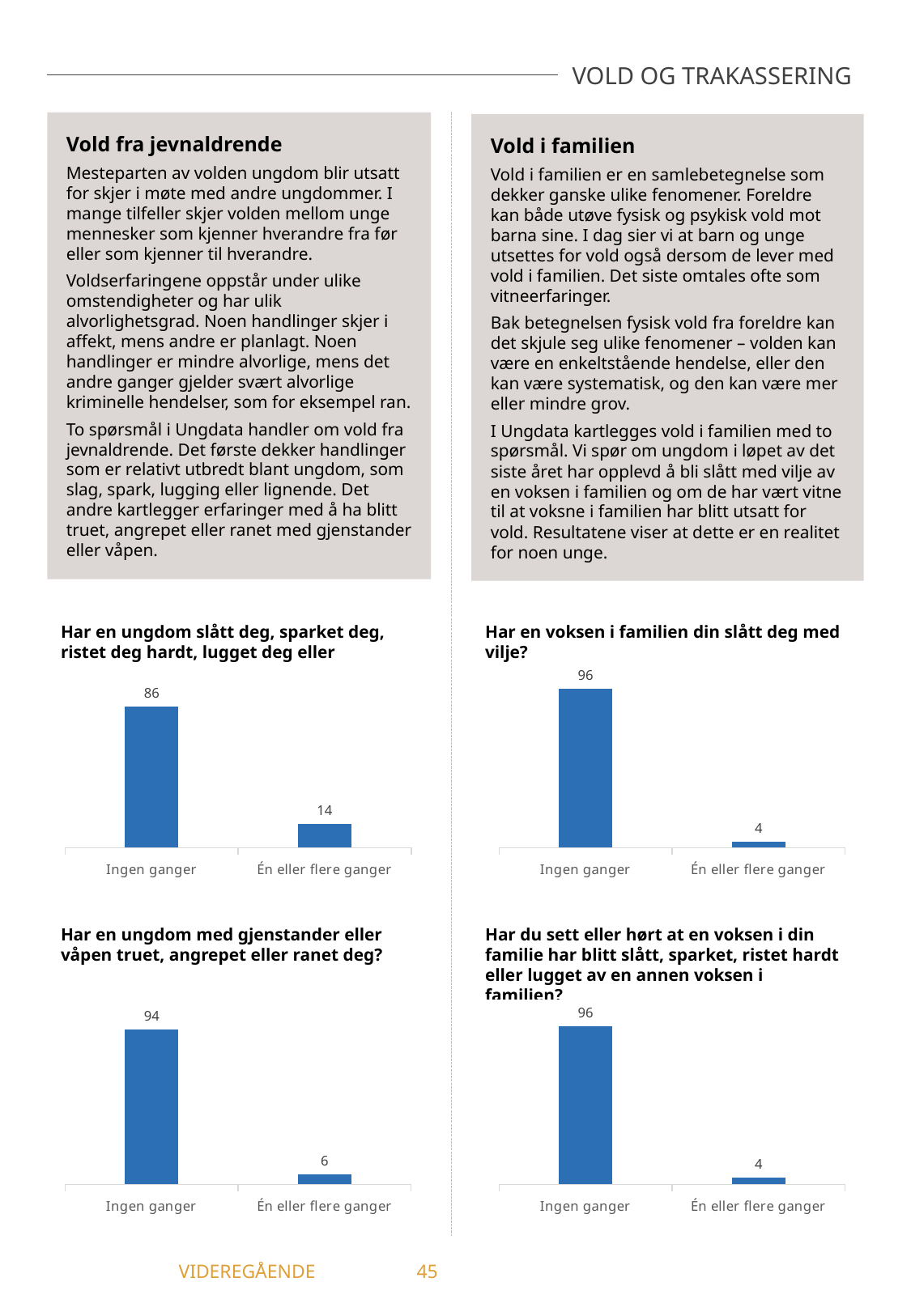
How many categories are shown in the bottom-right chart ("Har du sett eller hørt at en voksen i din familie har blitt slått...")? 2 In the bottom-right chart ("Har du sett eller hørt at en voksen i din familie har blitt slått..."), what is the value for "Én eller flere ganger"? 4 What type of chart is the top-left chart ("Har en ungdom slått deg, sparket deg...")? Bar chart In the bottom-left chart ("Har en ungdom med gjenstander eller våpen truet, angrepet eller ranet deg?"), what is the value for "Én eller flere ganger"? 6 In the bottom-left chart ("Har en ungdom med gjenstander eller våpen truet..."), what is the difference between "Ingen ganger" and "Én eller flere ganger"? 88 In the top-left chart ("Har en ungdom slått deg, sparket deg..."), what is the difference between "Ingen ganger" and "Én eller flere ganger"? 72 In the bottom-left chart ("Har en ungdom med gjenstander eller våpen truet, angrepet eller ranet deg?"), what is the value for "Ingen ganger"? 94 In the top-left chart ("Har en ungdom slått deg, sparket deg..."), what is the value for "Én eller flere ganger"? 14 In the top-left chart ("Har en ungdom slått deg, sparket deg, ristet deg hardt, lugget deg eller"), what is the value for "Ingen ganger"? 86 In the top-right chart ("Har en voksen i familien din slått deg med vilje?"), which category has the highest value? Ingen ganger In the top-right chart ("Har en voksen i familien din slått deg med vilje?"), what is the value for "Ingen ganger"? 96 In the top-right chart ("Har en voksen i familien din slått deg med vilje?"), what is the value for "Én eller flere ganger"? 4